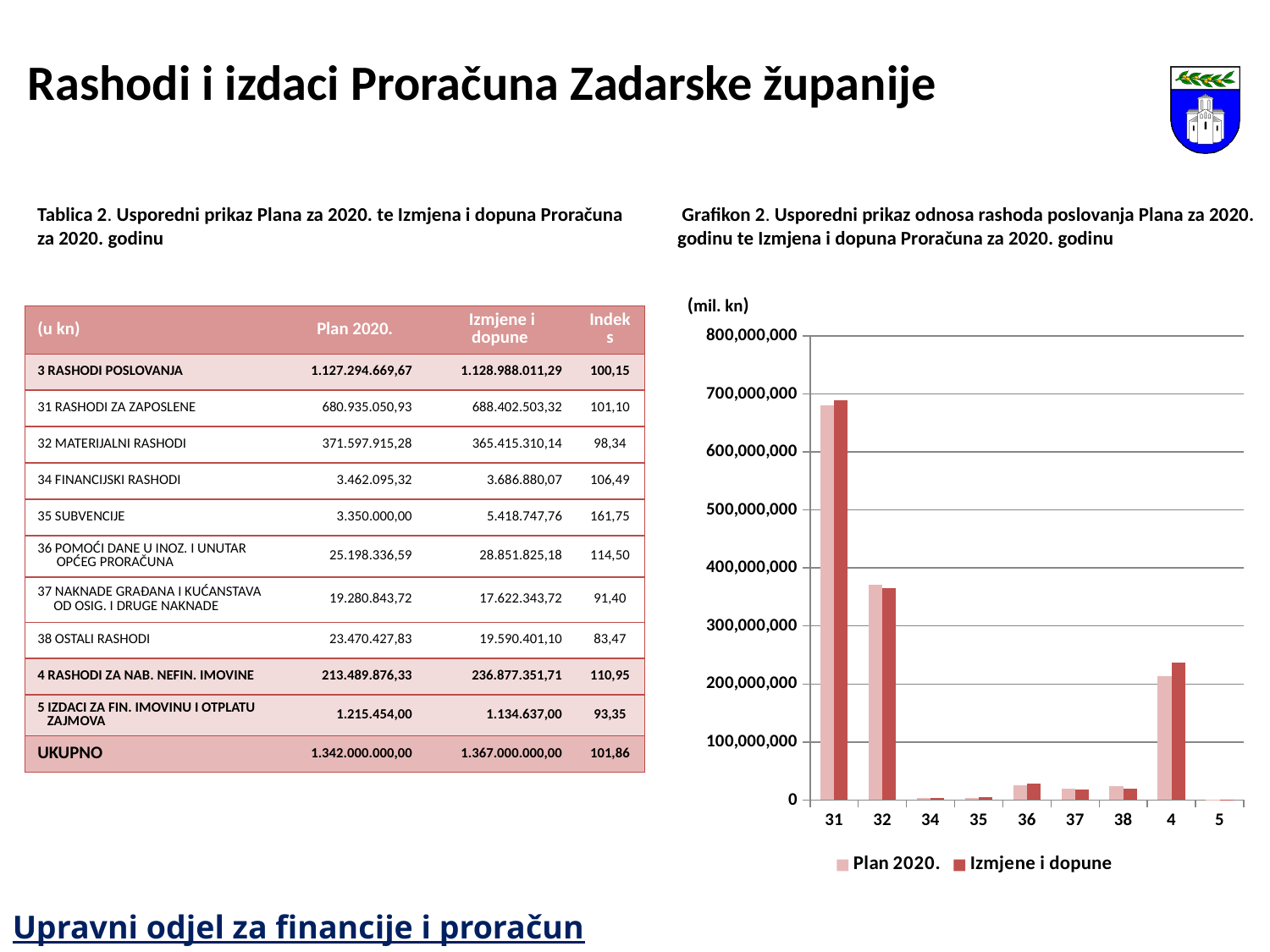
In the chart, which category has a larger Plan 2020. bar: 31 or 32? 31 What are the two series named in the chart legend? Plan 2020. and Izmjene i dopune Which category has the lowest bars in the chart? 5 How many series does the legend of the chart list? 2 In the chart, which is larger for category 4: the Plan 2020. bar or the Izmjene i dopune bar? Izmjene i dopune What kind of chart is Grafikon 2 on the slide? bar chart In the chart, is the Plan 2020. bar for category 31 greater or less than 600,000,000? greater In the chart, is the Plan 2020. bar for category 38 greater or less than 100,000,000? less How many categories are shown on the x axis of the chart? 9 Which category has the highest Plan 2020. bar in the chart? 31 Which category has the highest Izmjene i dopune bar in the chart? 31 In the chart, is the Izmjene i dopune bar for category 32 greater or less than 400,000,000? less